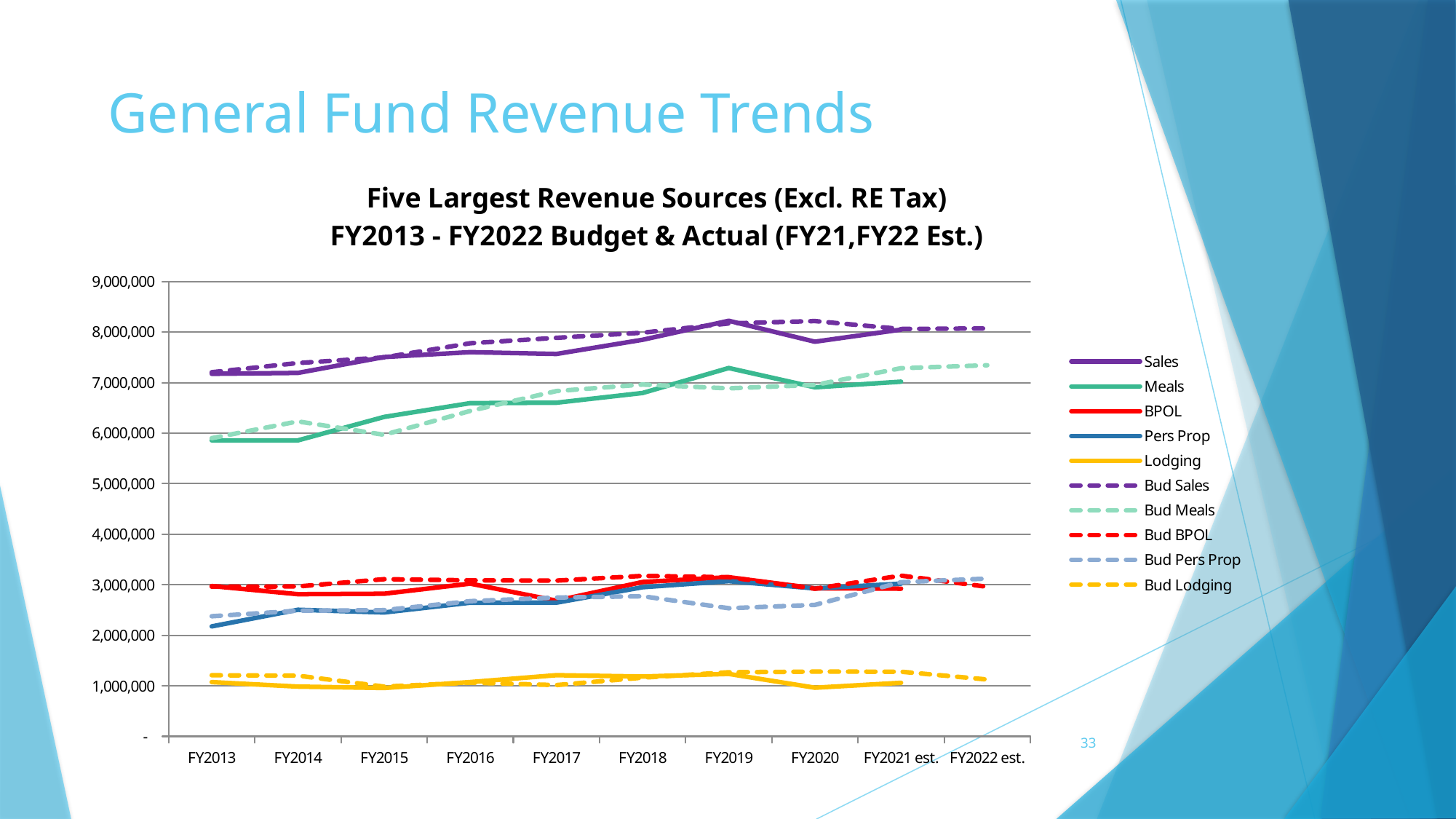
How many fiscal years are shown along the x axis? 10 Is the value for Meals in FY2013 greater or less than 6,000,000? less In FY2019, which is larger, Sales or Meals? Sales Is the value for Sales in FY2013 greater or less than 7,000,000? greater Which revenue source has the lowest values across the chart? Lodging What kind of chart is shown on the slide? Line chart Is the value for BPOL in FY2014 greater or less than 3,000,000? less Does the Sales line rise or fall from FY2013 to FY2019? Rise How many series does the legend list? 10 What is the first line of the chart's title? Five Largest Revenue Sources (Excl. RE Tax) Which revenue source has the highest values across the chart? Sales